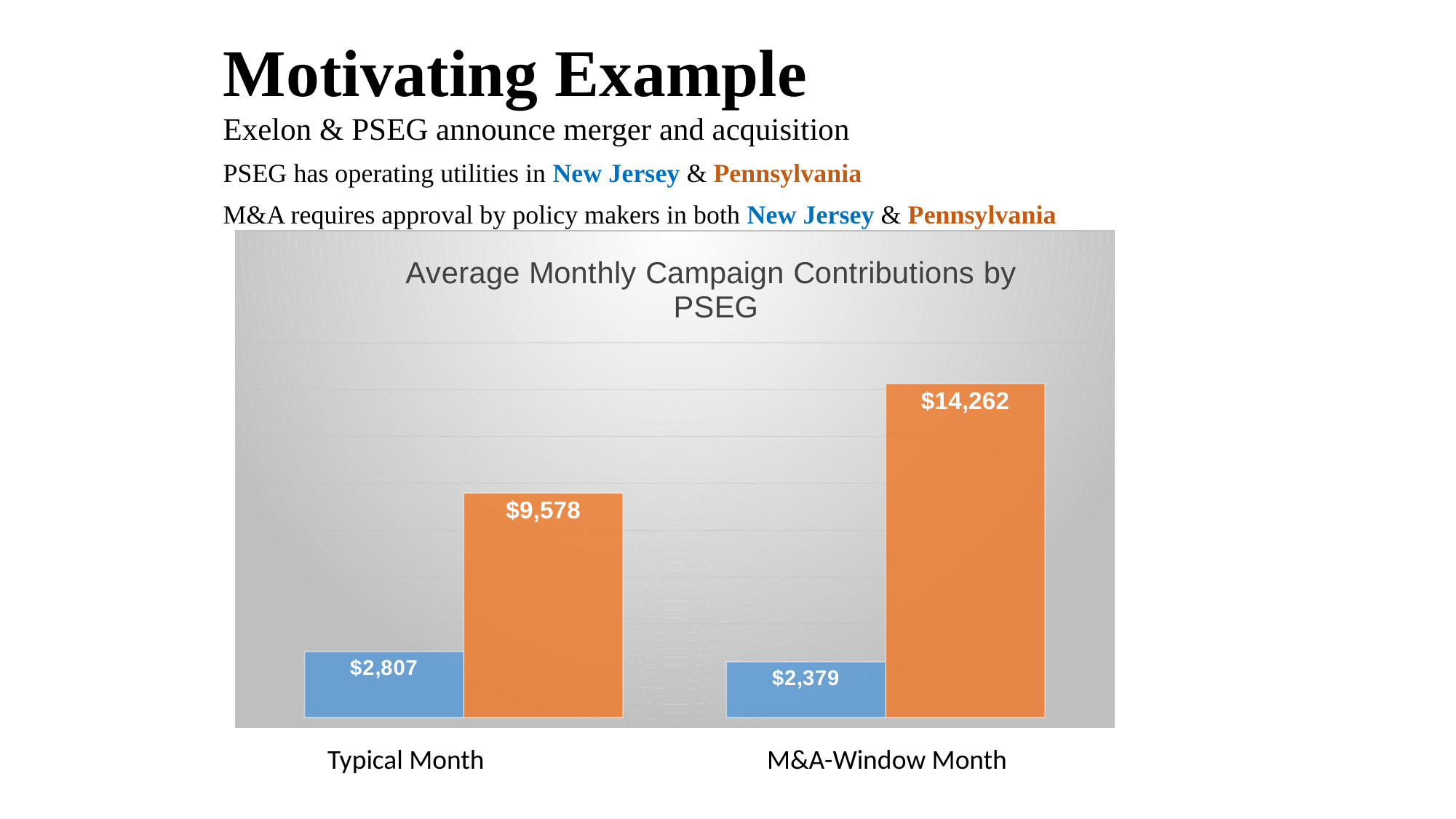
Which bar has the lowest value on the chart? The blue bar for M&A-Window Month ($2,379) What type of chart is shown on the slide? Bar chart How many categories are shown on the x axis? 2 Which is larger: the blue bar for Typical Month or the blue bar for M&A-Window Month? Typical Month What is the value of the orange bar for M&A-Window Month? $14,262 What is the value of the blue bar for Typical Month? $2,807 What is the difference between the orange bar values for M&A-Window Month and Typical Month? $4,684 What is the title of the chart? Average Monthly Campaign Contributions by PSEG Which bar has the highest value on the chart? The orange bar for M&A-Window Month ($14,262) What is the value of the blue bar for M&A-Window Month? $2,379 What is the value of the orange bar for Typical Month? $9,578 What is the difference between the orange bar and the blue bar for Typical Month? $6,771